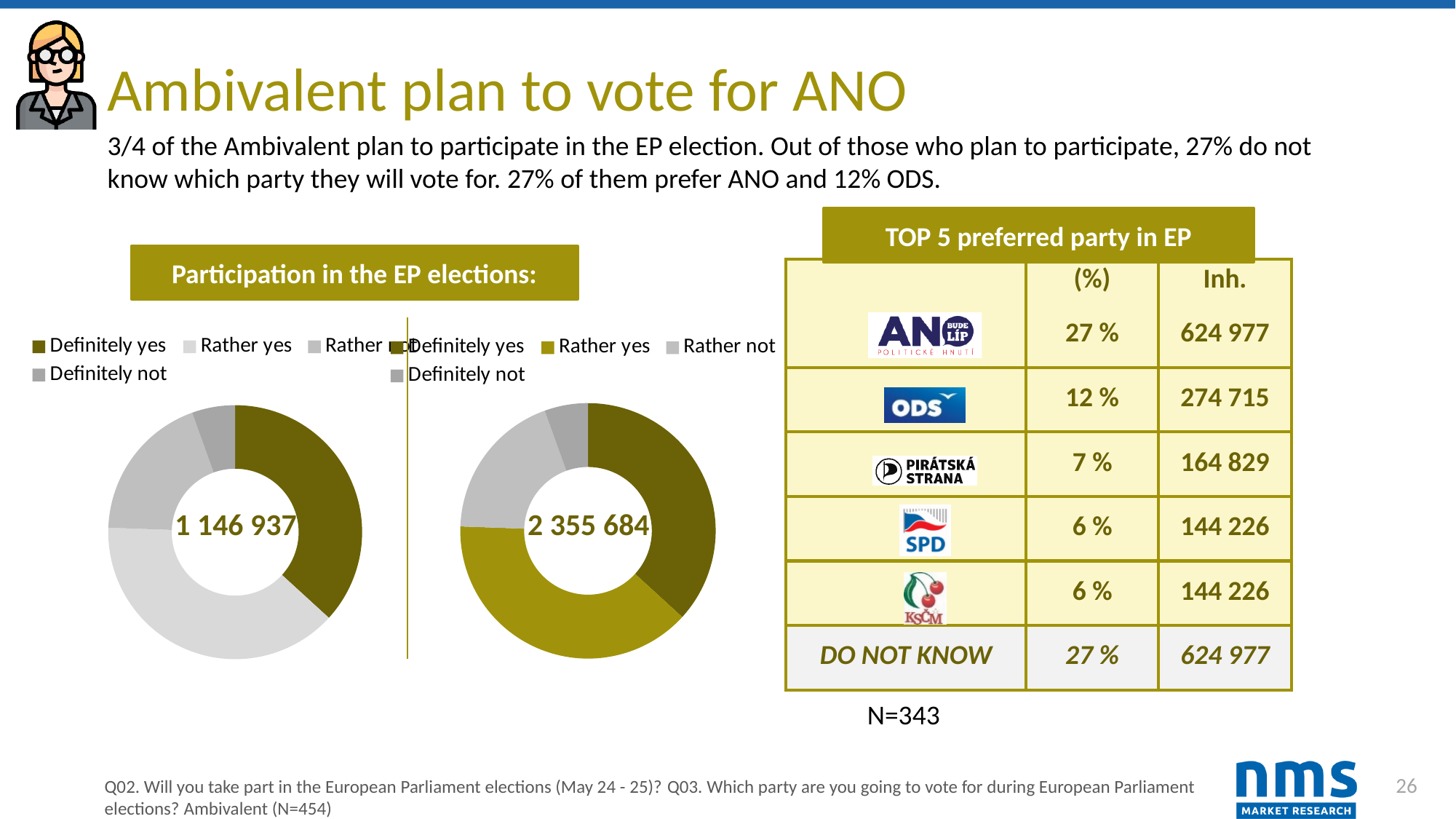
What kind of chart is used to show participation in the EP elections on the left side of the slide? doughnut (pie) chart In the right doughnut chart, which slice is larger: 'Rather yes' or 'Definitely not'? Rather yes In the right doughnut chart, which category has the smallest slice? Definitely not What is the heading printed above the two doughnut charts? Participation in the EP elections: Which legend entry of the doughnut charts is shown in the darkest olive colour? Definitely yes How many doughnut charts are shown under the heading 'Participation in the EP elections:'? 2 In the left doughnut chart, which slice is larger: 'Rather not' or 'Definitely not'? Rather not In the right doughnut chart, which slice is larger: 'Definitely yes' or 'Rather not'? Definitely yes How many categories does the legend of the left doughnut chart list? 4 In the left doughnut chart, which category has the smallest slice? Definitely not What value is printed in the centre of the left doughnut chart? 1 146 937 What value is printed in the centre of the right doughnut chart? 2 355 684